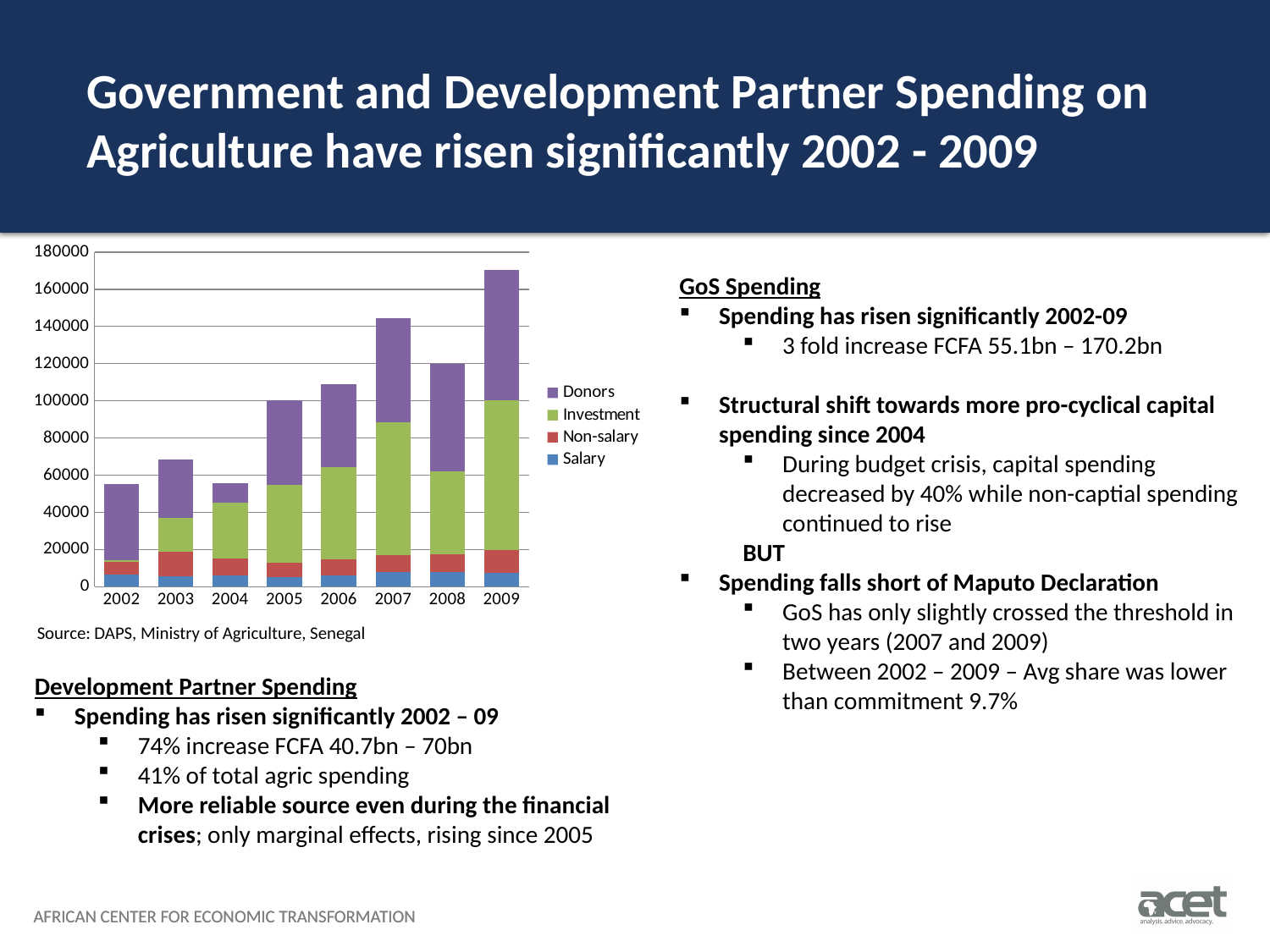
Is the total stacked bar for 2006 greater or less than 100000? greater Is the total stacked bar for 2002 greater or less than 60000? less What kind of chart is shown on the slide? stacked bar chart How many years are shown on the x axis of the chart? 8 Which year has the larger total stacked bar, 2007 or 2008? 2007 Which series is shown in purple in the chart's legend? Donors Is the total stacked bar for 2009 greater or less than 160000? greater Which series appears at the bottom of each stacked bar? Salary How many series does the chart's legend list? 4 Which year has the tallest stacked bar in the chart? 2009 Do the total stacked bars generally rise or fall from 2002 to 2009? rise